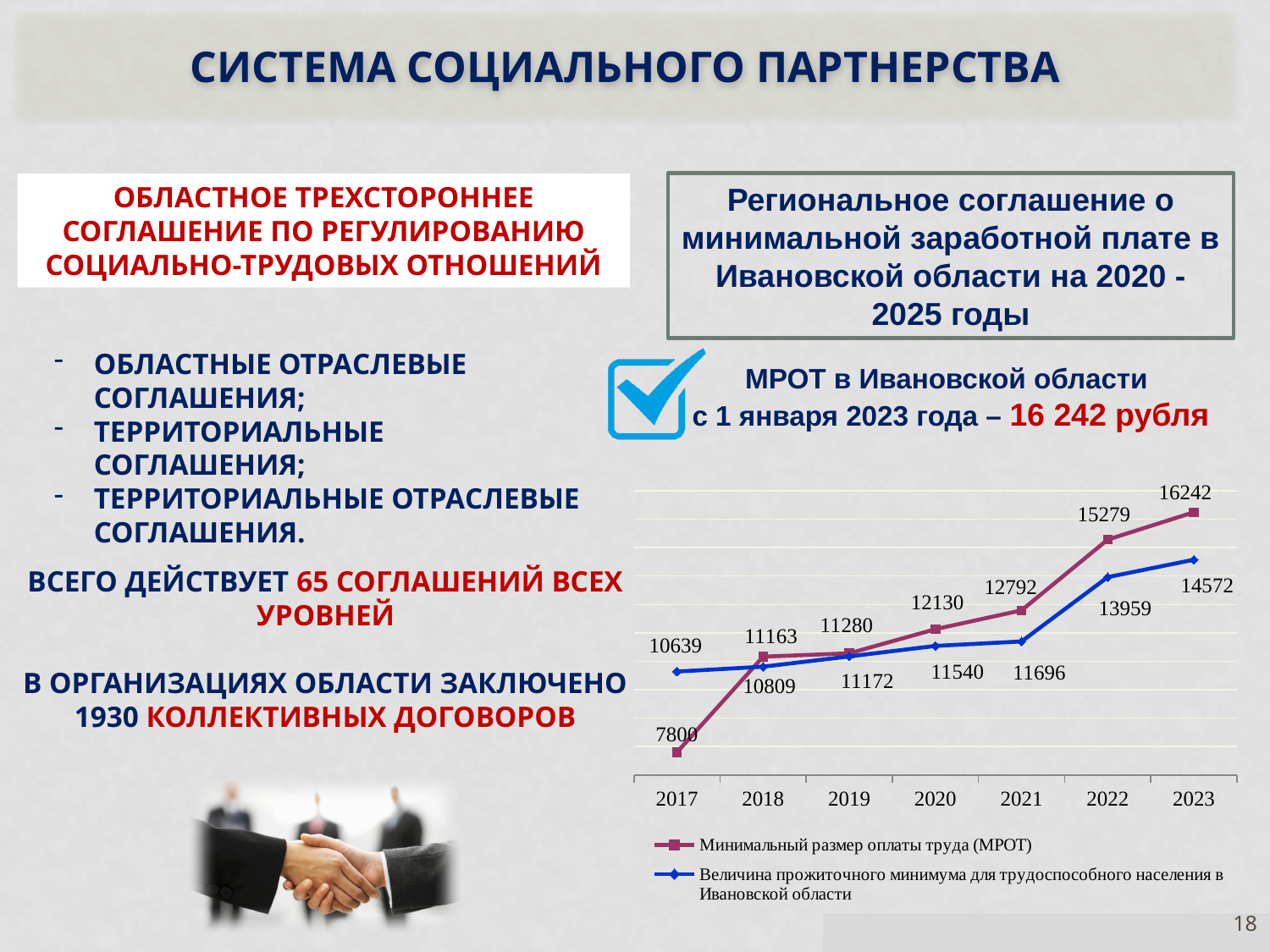
What is the value of Минимальный размер оплаты труда (МРОТ) in 2023? 16242 What type of chart is shown on the slide? line chart What is the difference between МРОТ and Величина прожиточного минимума in 2023? 1670 What is the value of Величина прожиточного минимума для трудоспособного населения in 2023? 14572 How many series does the chart legend list? 2 In which year is Величина прожиточного минимума для трудоспособного населения highest? 2023 In which year is Минимальный размер оплаты труда (МРОТ) lowest? 2017 Does Минимальный размер оплаты труда (МРОТ) rise or fall from 2017 to 2023? rise In 2017, which is larger: МРОТ or Величина прожиточного минимума? Величина прожиточного минимума What is the value of Величина прожиточного минимума для трудоспособного населения in 2020? 11540 What is the value of Минимальный размер оплаты труда (МРОТ) in 2017? 7800 How many years are shown on the x axis of the chart? 7